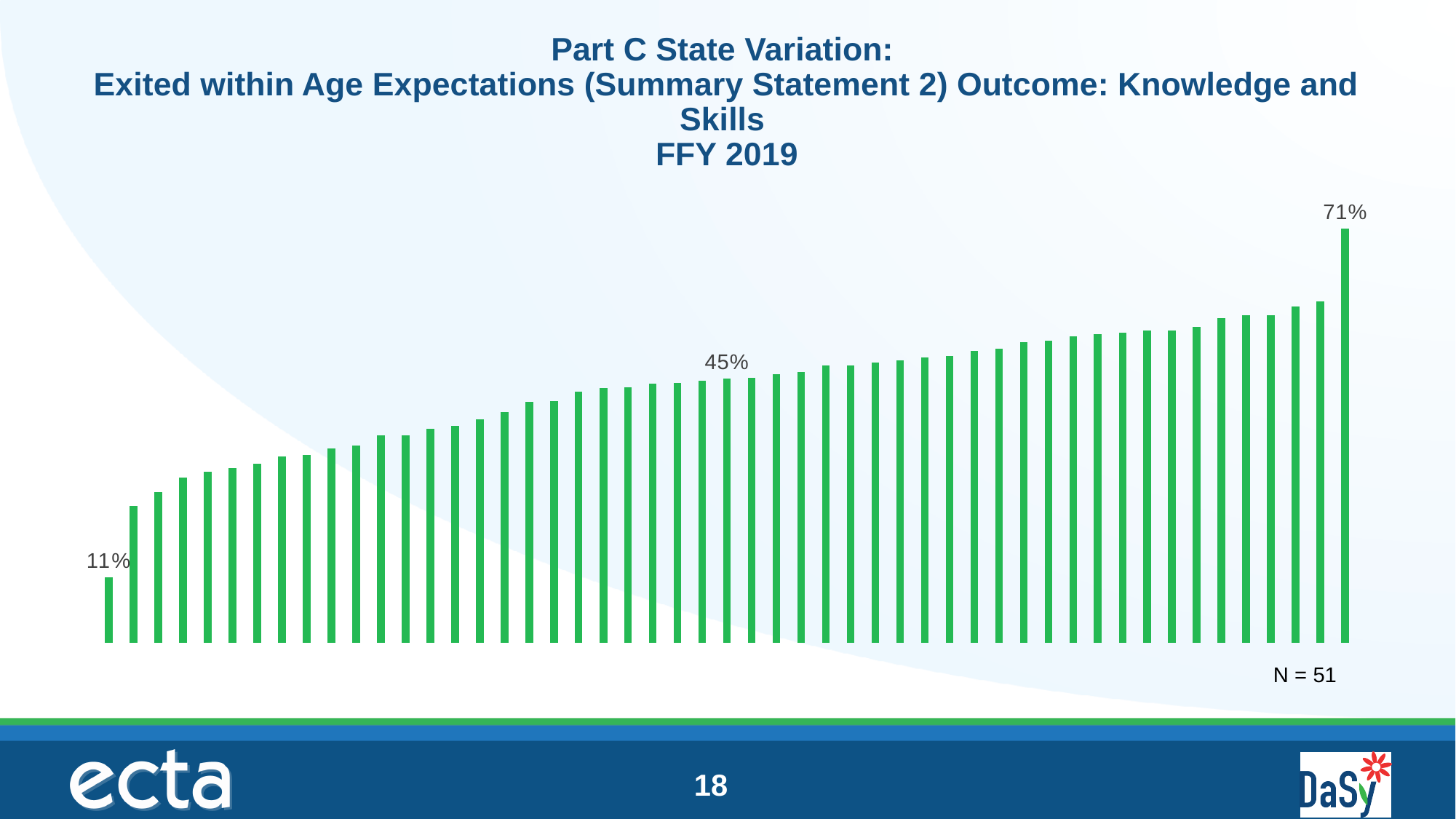
What is the difference between the 71% bar and the 45% bar? 26 percentage points Do the bar values rise or fall from left to right across the chart? Rise What kind of chart is shown on the slide? Bar chart What value is labeled on the bar in the middle of the chart? 45% Which outcome does the chart report on? Knowledge and Skills What is the difference between the highest labeled value (71%) and the lowest labeled value (11%)? 60 percentage points What is the value shown for the lowest bar in the chart? 11% What is the value shown for the highest bar in the chart? 71% How many states (N) are represented in the chart? 51 Which fiscal year does the chart cover? FFY 2019 Which is larger, the leftmost bar or the rightmost bar? The rightmost bar